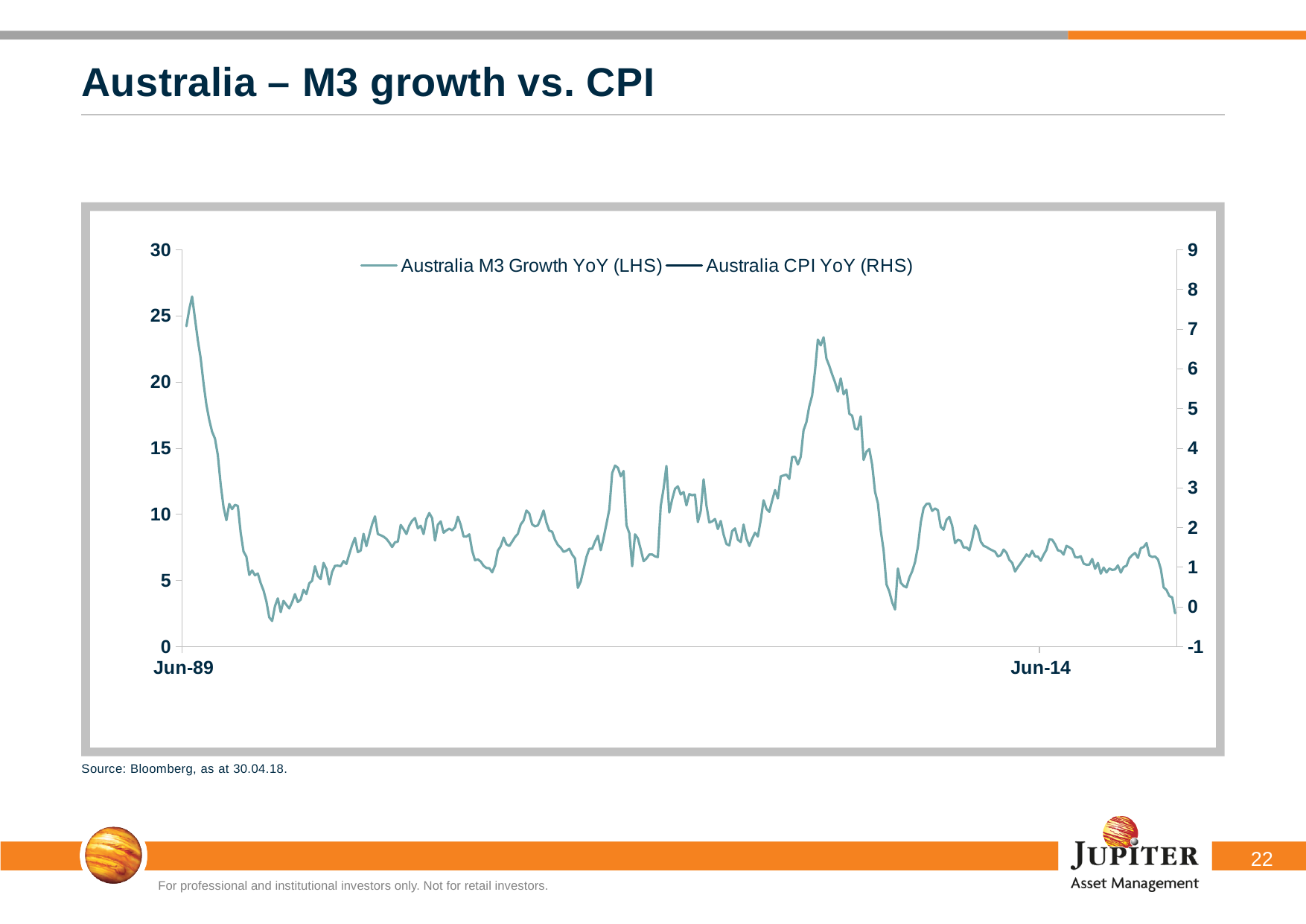
What is the second date label shown on the x axis? Jun-14 Is the Australia M3 Growth YoY value at the end of the series (right edge) greater or less than 5 on the left-hand axis? less What is the maximum value shown on the left-hand axis? 30 How many series does the chart legend list? 2 What kind of chart is shown on the slide? Line chart Is the lowest point of the Australia M3 Growth YoY line greater or less than 5 on the left-hand axis? less What is the minimum value shown on the right-hand axis? -1 Does the Australia M3 Growth YoY line rise or fall in the first few years after Jun-89? Fall Is the Australia M3 Growth YoY value at Jun-89 greater or less than 20 on the left-hand axis? greater Which series is plotted on the left-hand axis (LHS) according to the legend? Australia M3 Growth YoY What is the first date label shown on the x axis? Jun-89 What is the title of the slide's chart? Australia – M3 growth vs. CPI